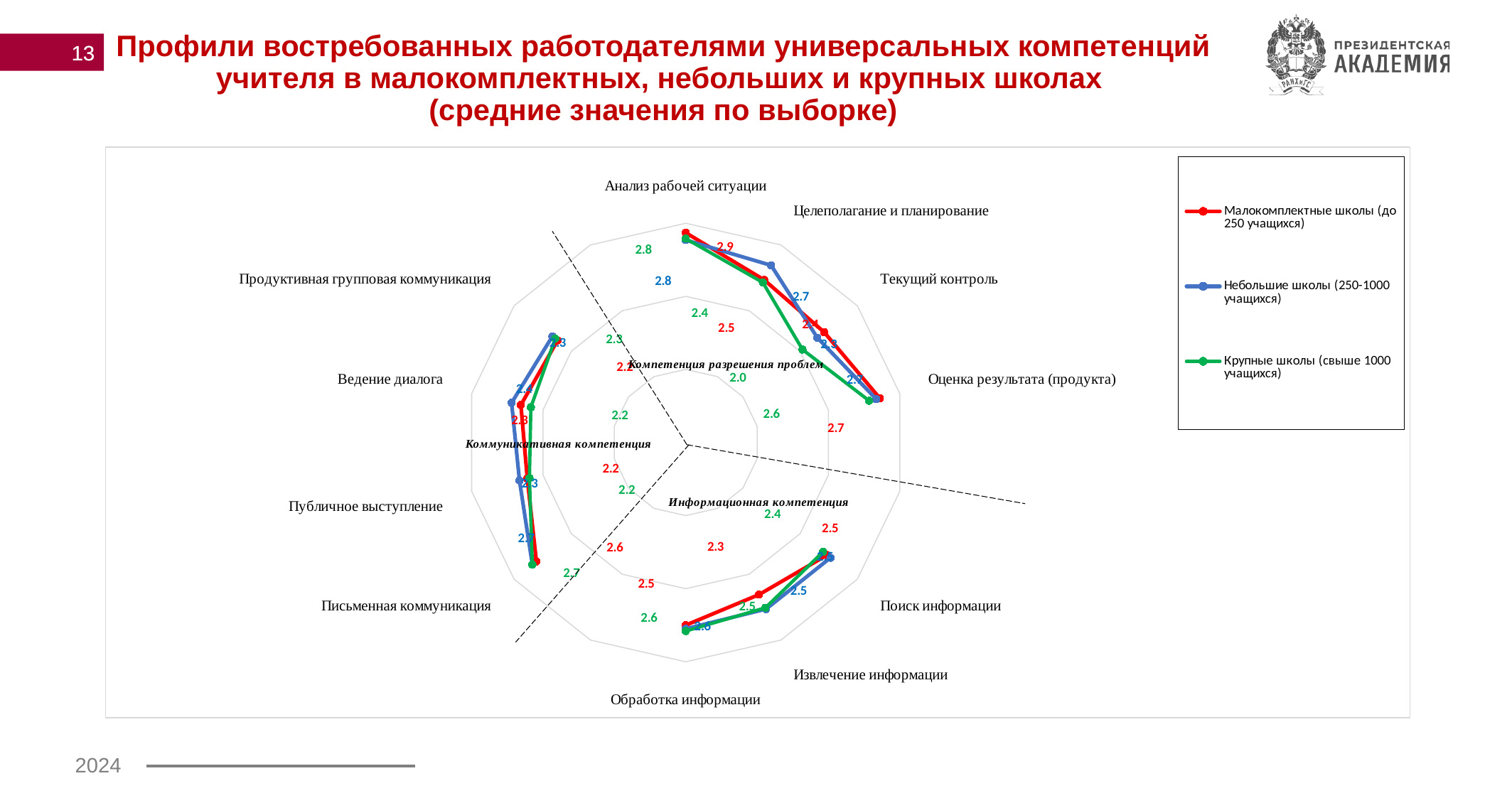
What kind of chart is shown on the slide? radar chart Which series is drawn in green according to the legend? Крупные школы (свыше 1000 учащихся) How many series does the legend list? 3 For Текущий контроль, is the value for Малокомплектные школы larger or smaller than the value for Крупные школы? larger For Ведение диалога, is the value for Небольшие школы larger or smaller than the value for Крупные школы? larger For Текущий контроль, which series has the lowest value? Крупные школы (свыше 1000 учащихся) How many competency categories are plotted around the radar chart? 11 Which series is drawn in red according to the legend? Малокомплектные школы (до 250 учащихся) For Ведение диалога, which series has the highest value? Небольшие школы (250-1000 учащихся) For Целеполагание и планирование, which series has the highest value: Малокомплектные школы, Небольшие школы or Крупные школы? Небольшие школы (250-1000 учащихся)